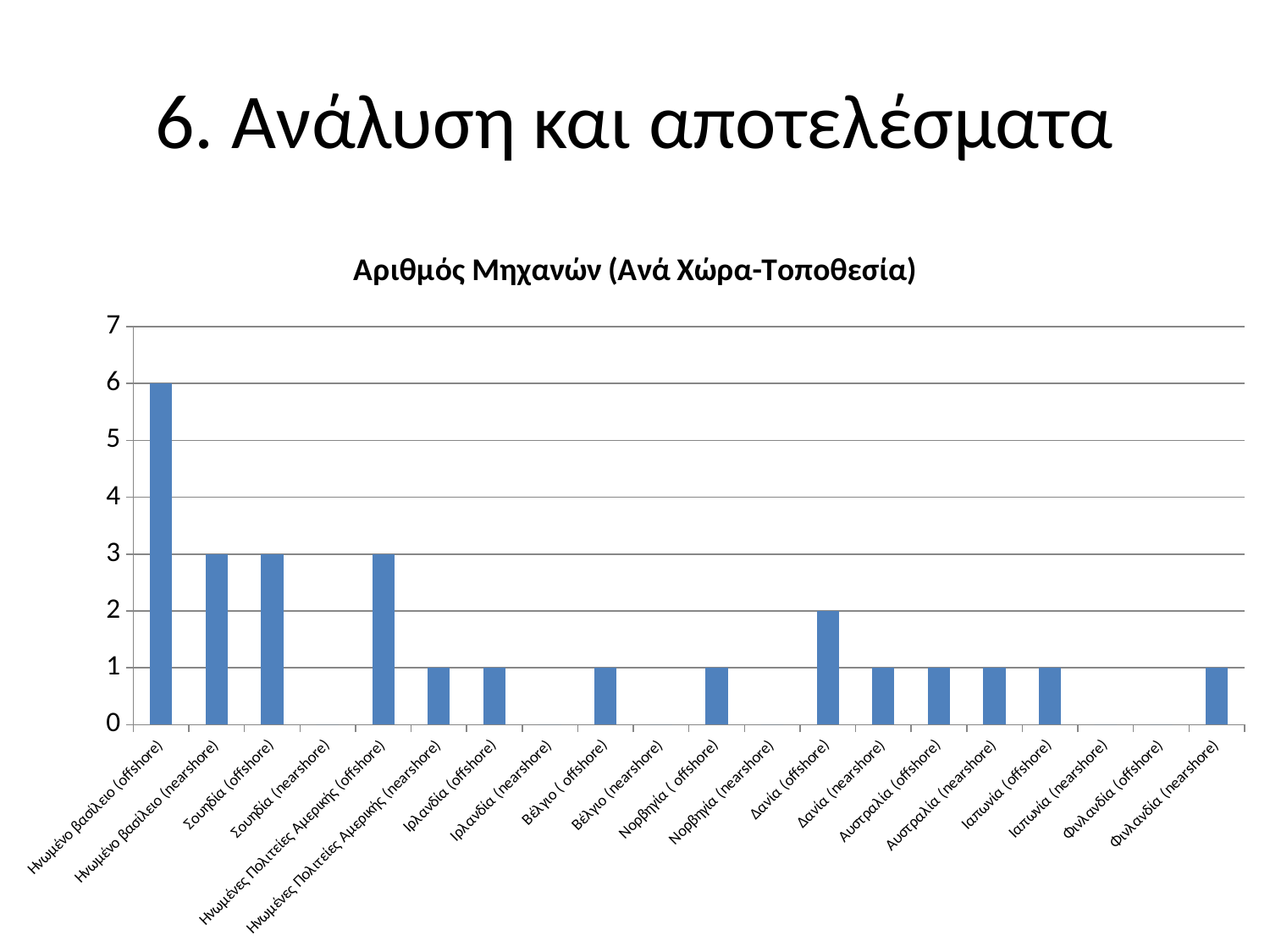
Which category has the highest value? Ηνωμένο βασίλειο (offshore) What is the value for Ηνωμένο βασίλειο (offshore)? 6 How many categories are shown on the x axis? 20 Which is larger, Δανία (offshore) or Δανία (nearshore)? Δανία (offshore) What is the value for Ιρλανδία (nearshore)? 0 What is the value for Ηνωμένες Πολιτείες Αμερικής (offshore)? 3 Is the value for Ηνωμένο βασίλειο (offshore) greater or less than 5? greater What is the title of the chart? Αριθμός Μηχανών (Ανά Χώρα-Τοποθεσία) What is the value for Σουηδία (offshore)? 3 What kind of chart is this? bar chart What is the value for Δανία (offshore)? 2 What is the difference between Ηνωμένο βασίλειο (offshore) and Ηνωμένο βασίλειο (nearshore)? 3